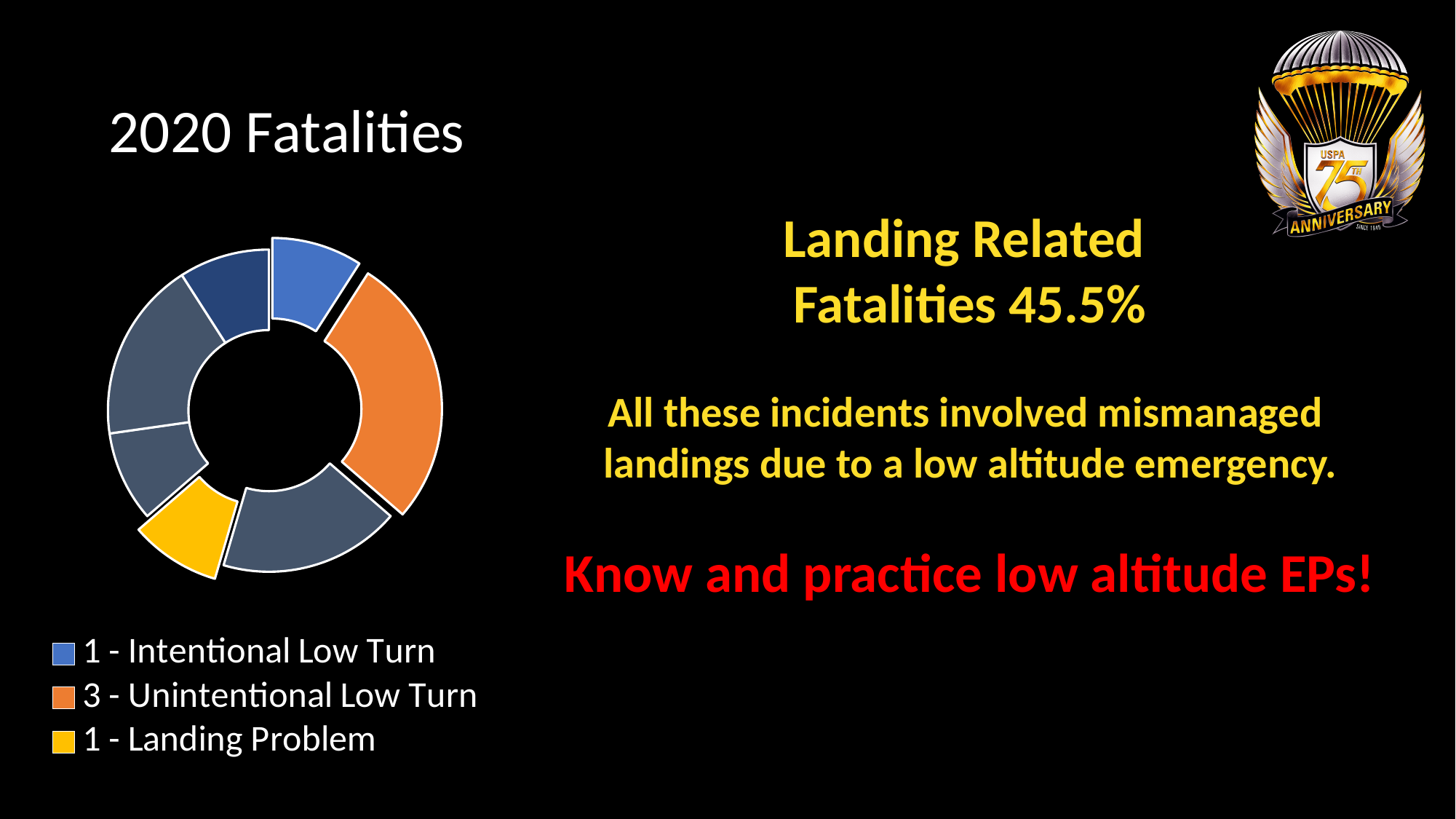
Which is larger: the number of Unintentional Low Turn fatalities or Intentional Low Turn fatalities? Unintentional Low Turn How many fatalities are attributed to Intentional Low Turn? 1 What is the difference between the number of Unintentional Low Turn fatalities and Landing Problem fatalities? 2 How many fatalities are attributed to Unintentional Low Turn? 3 What kind of chart is shown on the slide? Pie (donut) chart How many fatalities are attributed to Landing Problem? 1 What is the title of the chart? 2020 Fatalities How many entries does the chart's legend list? 3 Which colour represents Landing Problem in the chart? Yellow What is the combined total of the three labeled categories in the legend? 5 According to the slide, what percentage of fatalities were landing related? 45.5% Which of the labeled categories in the legend has the highest number of fatalities? Unintentional Low Turn